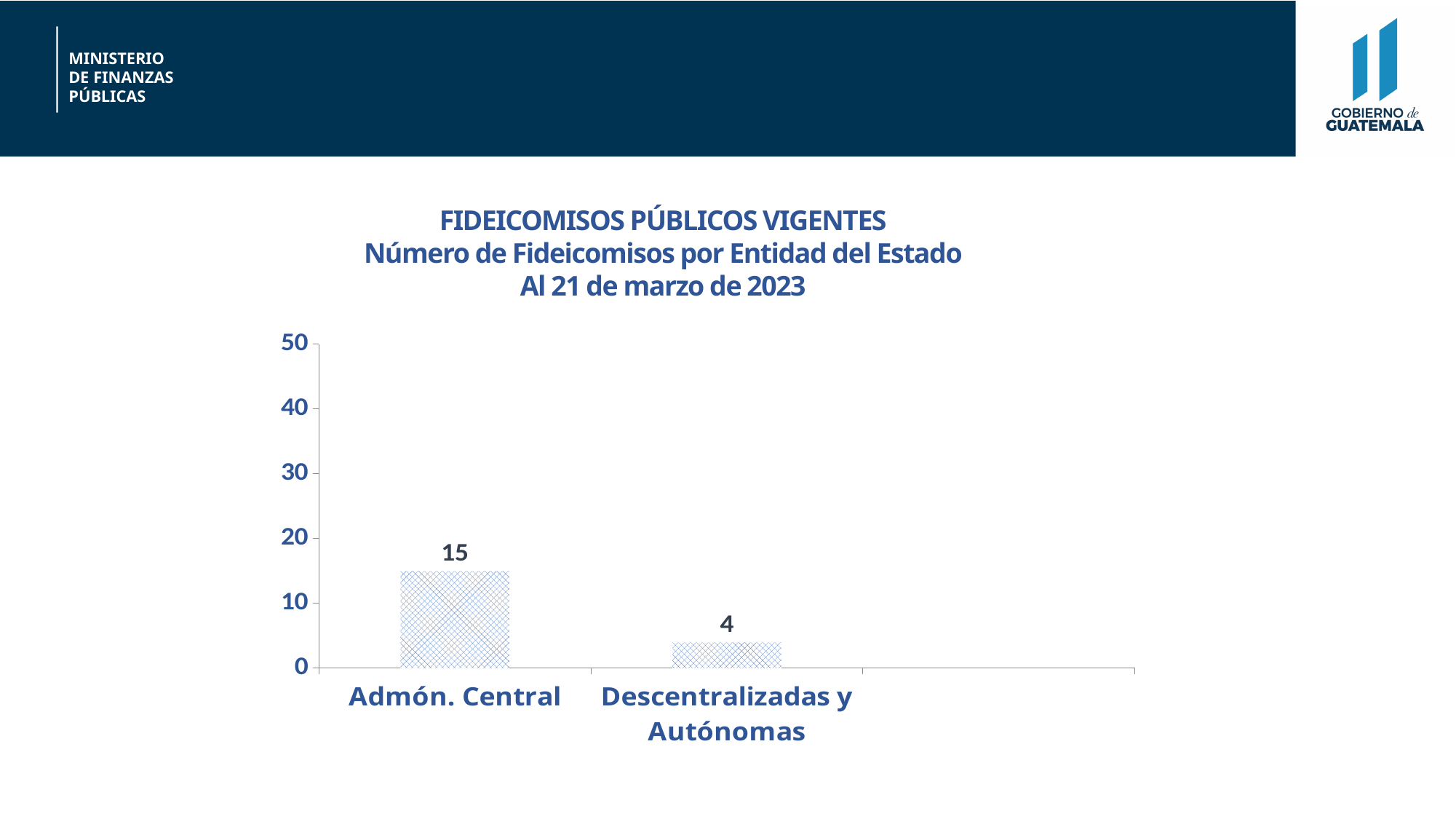
What is the value for Descentralizadas y Autónomas? 4 Which category has the lowest value? Descentralizadas y Autónomas What is the highest value shown on the y axis? 50 As of what date is the chart's data reported, according to the title? 21 de marzo de 2023 Is the value for Descentralizadas y Autónomas greater or less than 10? less What is the difference between the values for Admón. Central and Descentralizadas y Autónomas? 11 Which is larger, the value for Admón. Central or the value for Descentralizadas y Autónomas? Admón. Central What kind of chart is shown on the slide? bar chart How many categories are shown on the x axis? 2 Is the value for Admón. Central greater or less than 20? less Which category has the highest value? Admón. Central What is the value for Admón. Central? 15